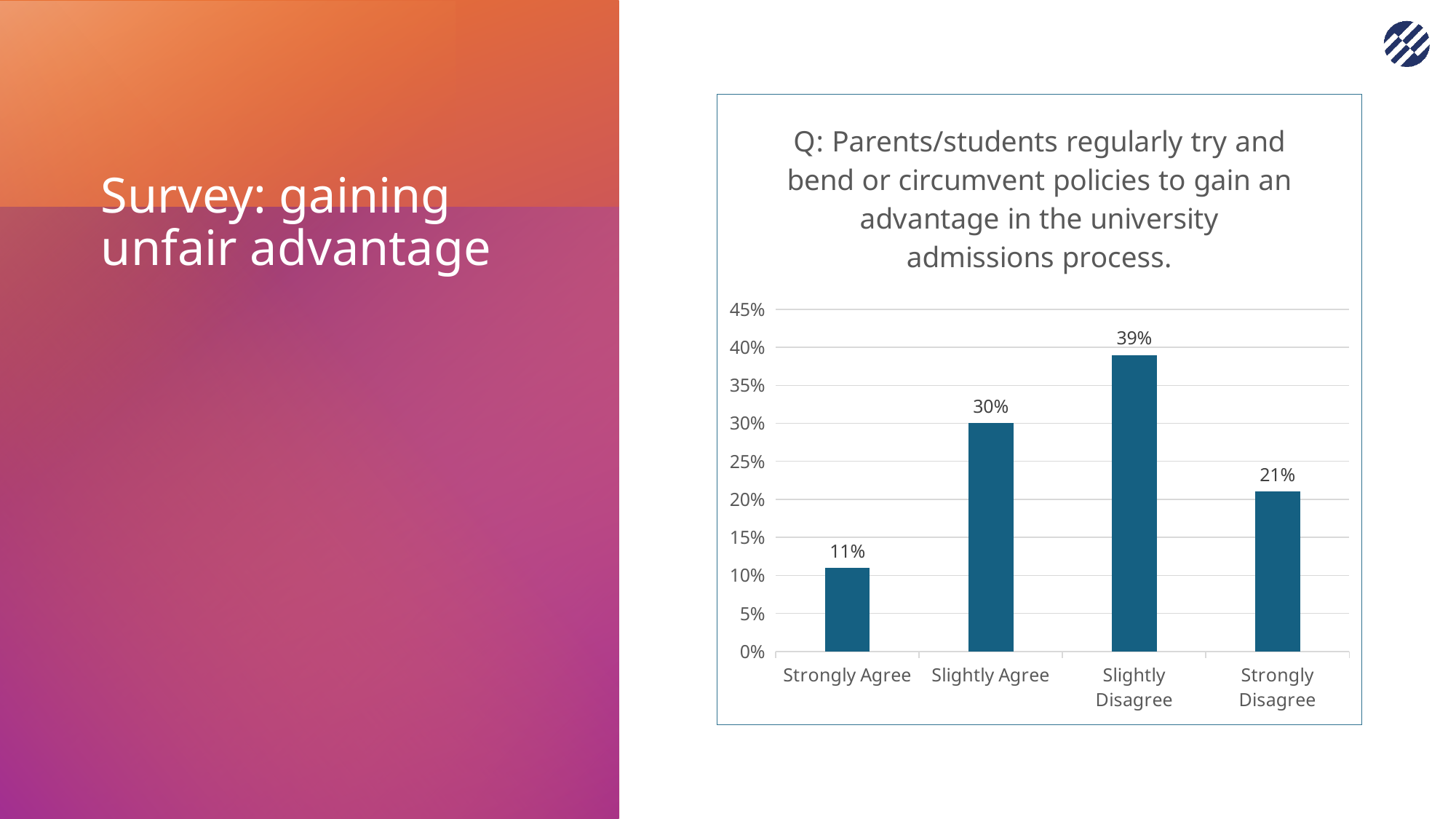
Is the value for Strongly Disagree greater or less than 25%? less What is the difference in percentage points between Slightly Disagree and Slightly Agree? 9% What is the highest value shown on the vertical axis? 45% What percentage of respondents answered Strongly Disagree? 21% Which response category has the highest percentage? Slightly Disagree How many response categories are shown on the x axis? 4 What percentage of respondents answered Strongly Agree? 11% Which response category has the lowest percentage? Strongly Agree Which is larger, the value for Slightly Agree or the value for Strongly Disagree? Slightly Agree What kind of chart is shown on the slide? bar chart What is the combined percentage of Strongly Agree and Slightly Agree responses? 41% What percentage of respondents answered Slightly Disagree? 39%